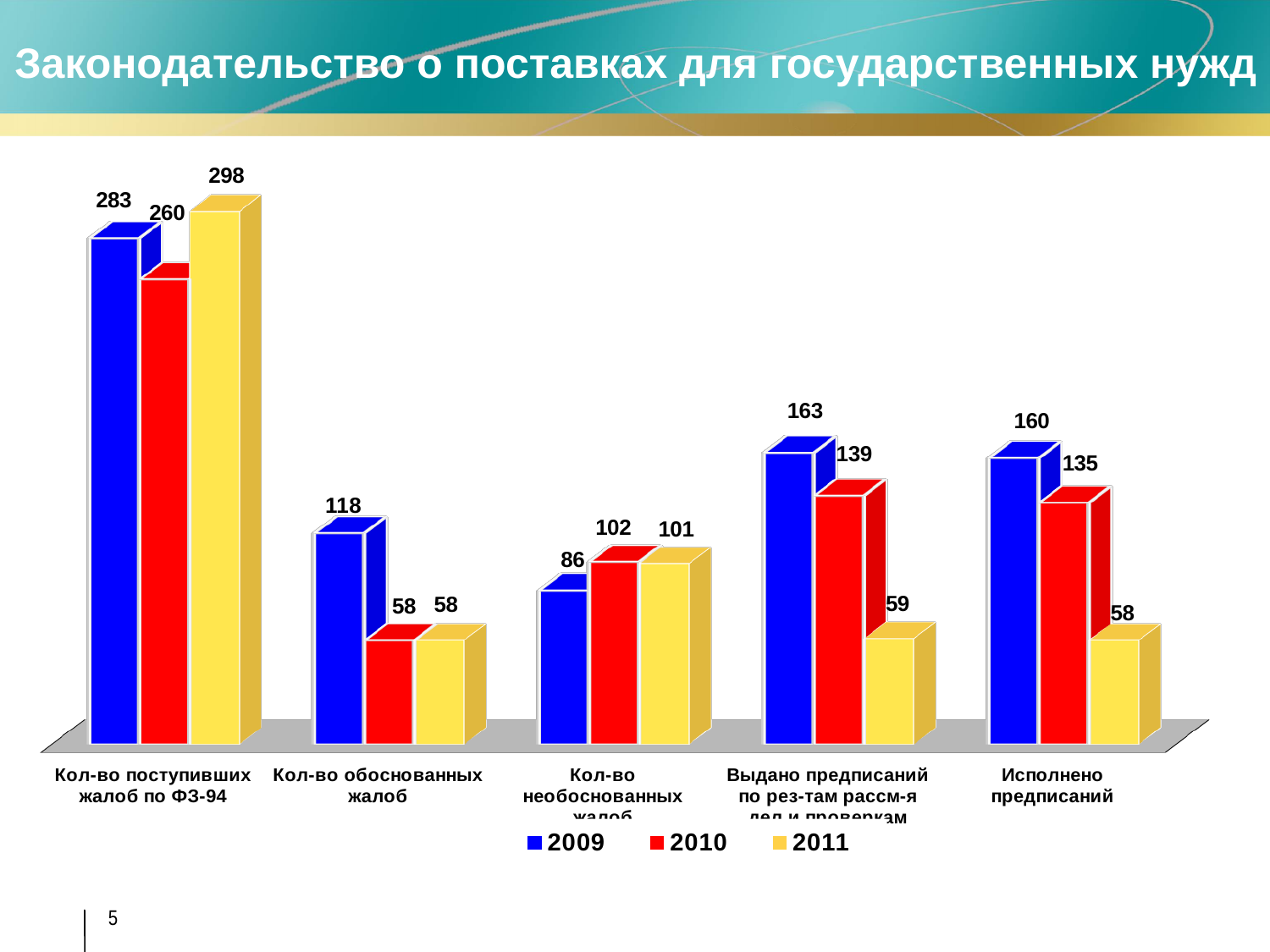
How many categories are shown on the x axis of the chart? 5 Which year has the highest value in the category "Кол-во поступивших жалоб по ФЗ-94"? 2011 What kind of chart is shown on the slide? Bar chart How many series does the legend list? 3 What is the value for 2009 in the category "Исполнено предписаний"? 160 What is the value for 2011 in the category "Кол-во поступивших жалоб по ФЗ-94"? 298 What is the value for 2010 in the category "Кол-во необоснованных жалоб"? 102 What is the difference between the 2009 and 2010 values in the category "Кол-во обоснованных жалоб"? 60 What is the difference between the 2011 and 2009 values in the category "Кол-во поступивших жалоб по ФЗ-94"? 15 Which is larger: the 2009 value for "Кол-во необоснованных жалоб" or the 2010 value for the same category? 2010 Which year has the lowest value in the category "Выдано предписаний"? 2011 What is the value for 2010 in the category "Кол-во обоснованных жалоб"? 58